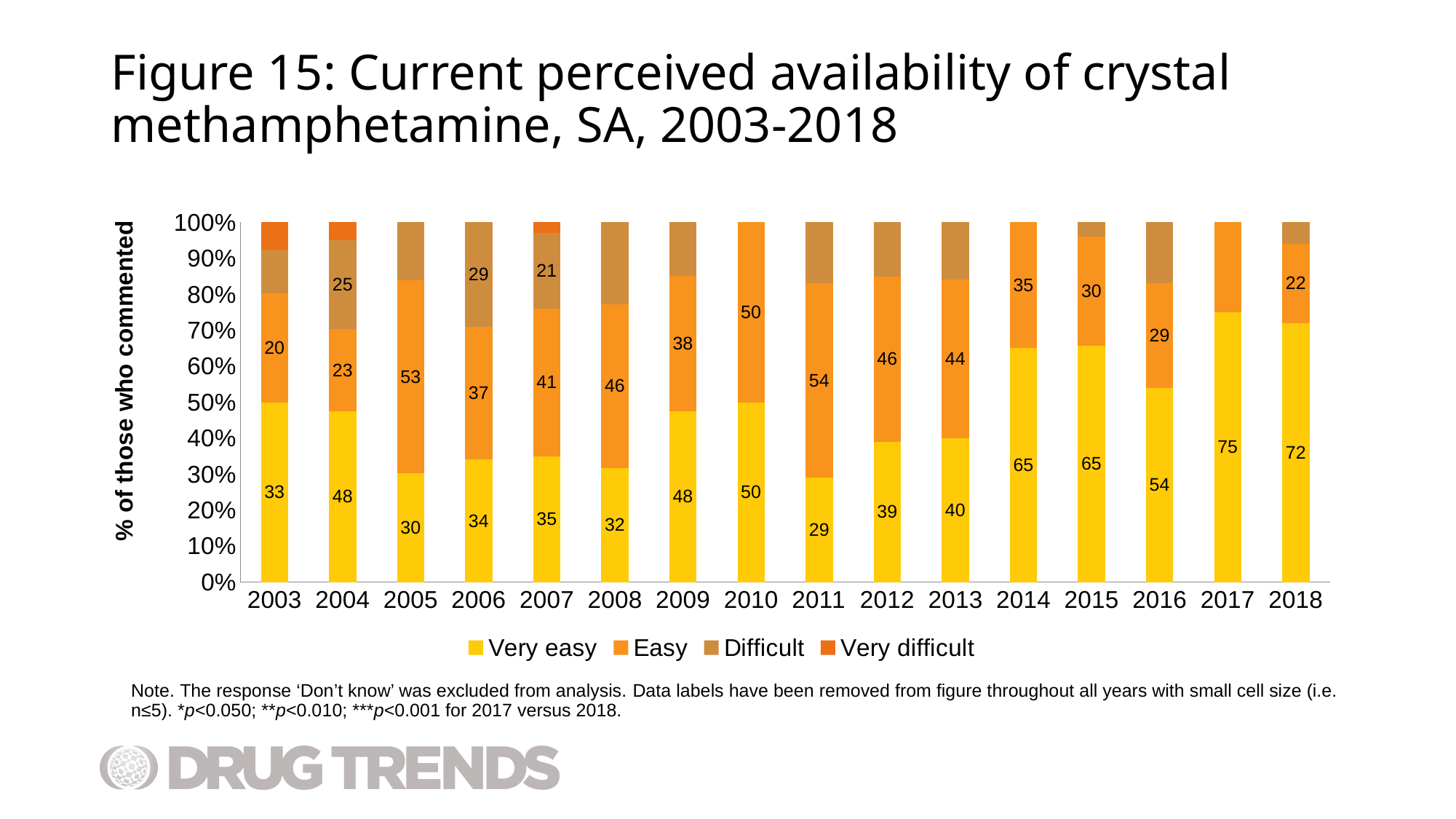
What is the data label for the Easy segment in 2011? 54 How many years are shown on the x axis? 16 What is the data label for the Very easy segment in 2018? 72 Which is larger, the Easy data label for 2005 or for 2008? 2005 What is the data label for the Very easy segment in 2017? 75 Is the Very easy share of the 2017 bar greater or less than 70%? greater Which year has the highest data label for the Very easy segment? 2017 What kind of chart is shown on the slide? Stacked bar chart What is the data label for the Difficult segment in 2006? 29 What is the difference between the Very easy data labels for 2017 and 2018? 3 How many series does the legend list? 4 Which year has the lowest data label for the Very easy segment? 2011